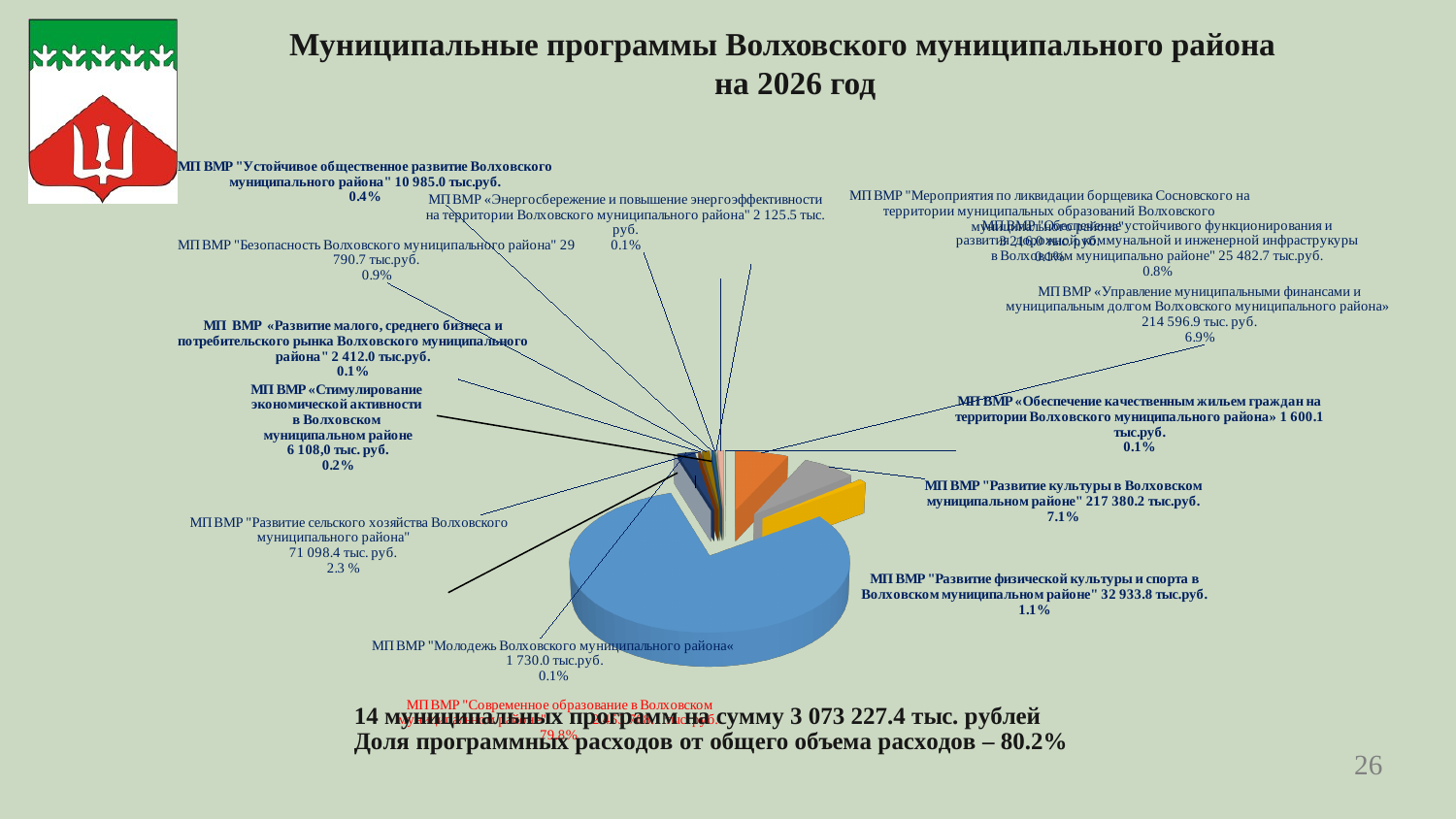
What is the total sum of the municipal programs stated on the slide? 3 073 227.4 тыс. рублей How many municipal programs does the slide say are included? 14 Which is larger: the value for "Безопасность Волховского муниципального района" or for "Обеспечение устойчивого функционирования и развития коммунальной и инженерной инфраструктуры в Волховском муниципальном районе"? Безопасность Волховского муниципального района What is the value shown for the program "Развитие культуры в Волховском муниципальном районе"? 217 380.2 тыс.руб. What share of the pie does the program "Современное образование в Волховском муниципальном районе" represent? 79.8% What share of the pie does the program "Развитие сельского хозяйства Волховского муниципального района" represent? 2.3 % What kind of chart is shown on the slide? pie chart What is the value shown for the program "Молодежь Волховского муниципального района"? 1 730.0 тыс.руб. What share of the pie does the program "Развитие культуры в Волховском муниципальном районе" represent? 7.1% Which program has the largest slice of the pie? МП ВМР "Современное образование в Волховском муниципальном районе" What is the value shown for the program "Управление муниципальными финансами и муниципальным долгом Волховского муниципального района"? 214 596.9 тыс. руб. What is the value shown for the program "Развитие физической культуры и спорта в Волховском муниципальном районе"? 32 933.8 тыс.руб.